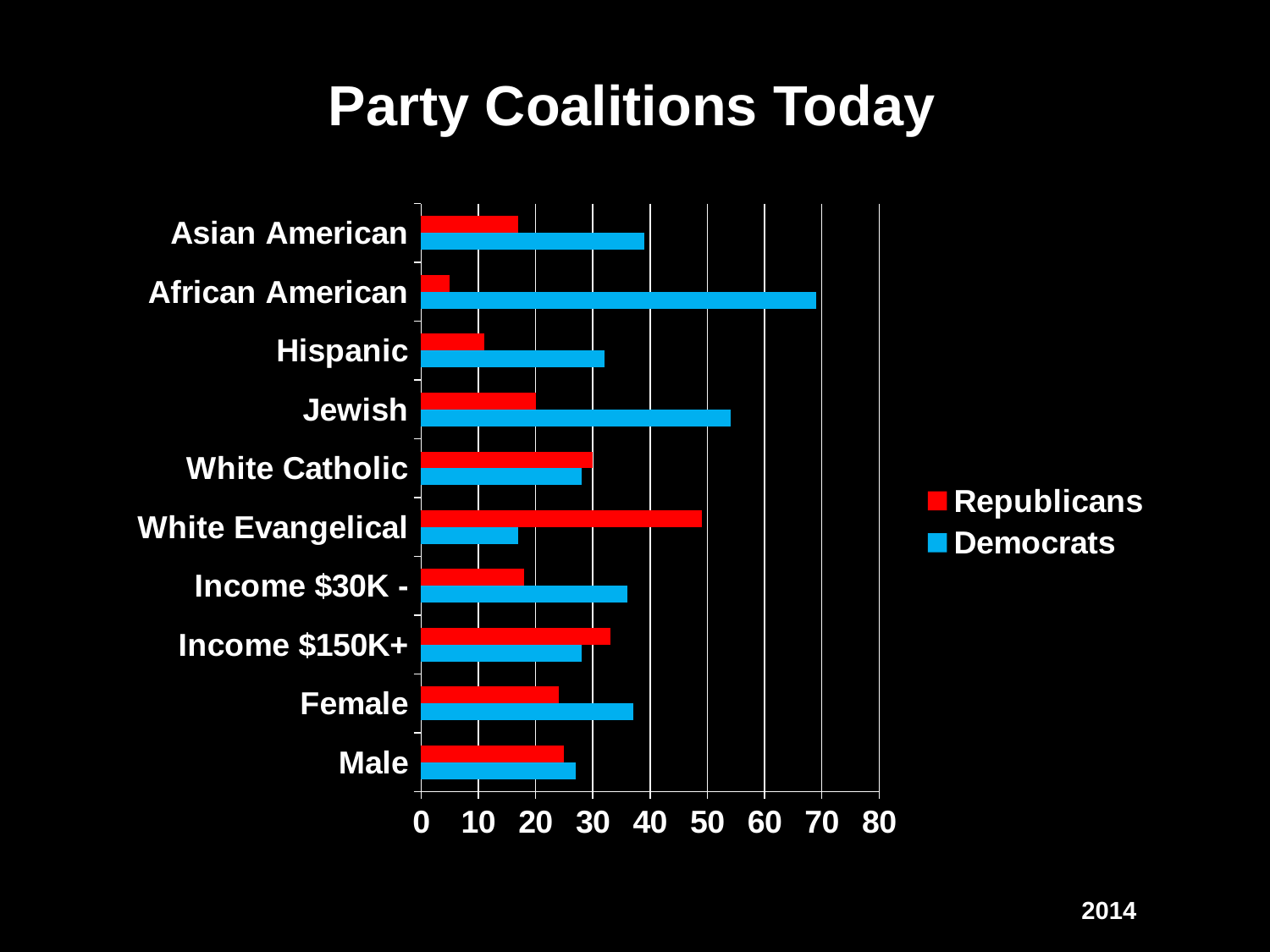
For the Jewish category, which is larger, the Republicans value or the Democrats value? Democrats How many series does the legend list? 2 Is the Republicans value for Hispanic greater or less than 20? less What kind of chart is shown on the slide? bar chart Which category has the lowest value for Democrats? White Evangelical Which category has the lowest value for Republicans? African American Which colour represents Republicans in the legend? red Which category has the highest value for Republicans? White Evangelical How many categories are shown on the chart? 10 What is the title of the chart? Party Coalitions Today Which category has the highest value for Democrats? African American Is the Democrats value for African American greater or less than 60? greater